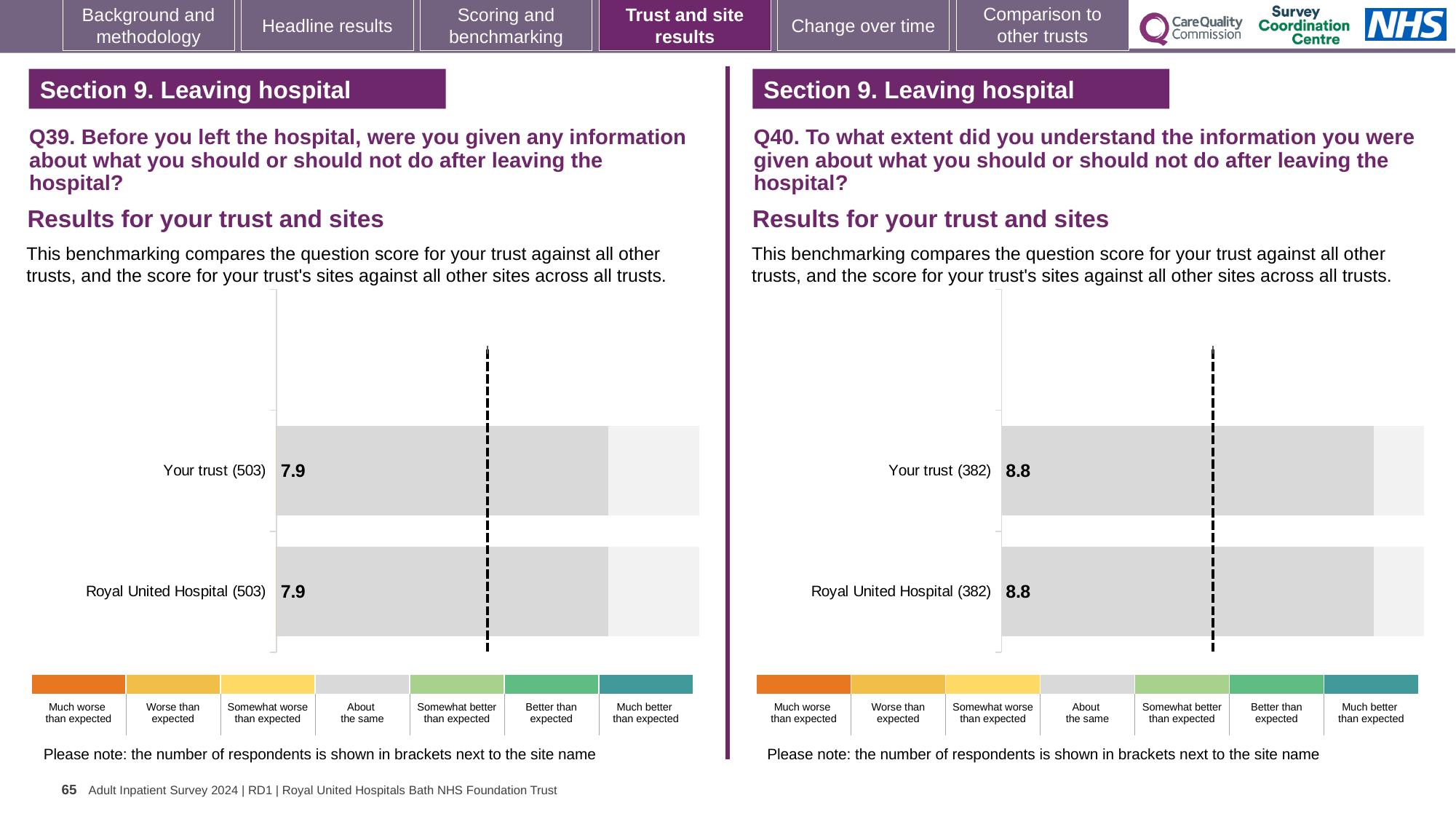
How many bars are plotted in the Q40 chart on the right? 2 In the Q39 chart on the left, what is the score for Your trust? 7.9 How many bars are plotted in the Q39 chart on the left? 2 In the Q40 chart on the right, what is the score for Your trust? 8.8 What kind of chart is used for the Q40 results on the right? Bar chart In the Q40 chart on the right, what is the score for Royal United Hospital? 8.8 In the Q39 chart on the left, what is the score for Royal United Hospital? 7.9 How many categories does the colour key below the Q40 chart list, from 'Much worse than expected' to 'Much better than expected'? 7 In the Q39 chart on the left, how many respondents are shown in brackets next to Your trust? 503 Is the Your trust score in the Q40 chart on the right greater or less than the Your trust score in the Q39 chart on the left? greater What is the difference between the Your trust score in the Q40 chart and the Your trust score in the Q39 chart? 0.9 What is the difference between the Your trust score and the Royal United Hospital score in the Q39 chart on the left? 0